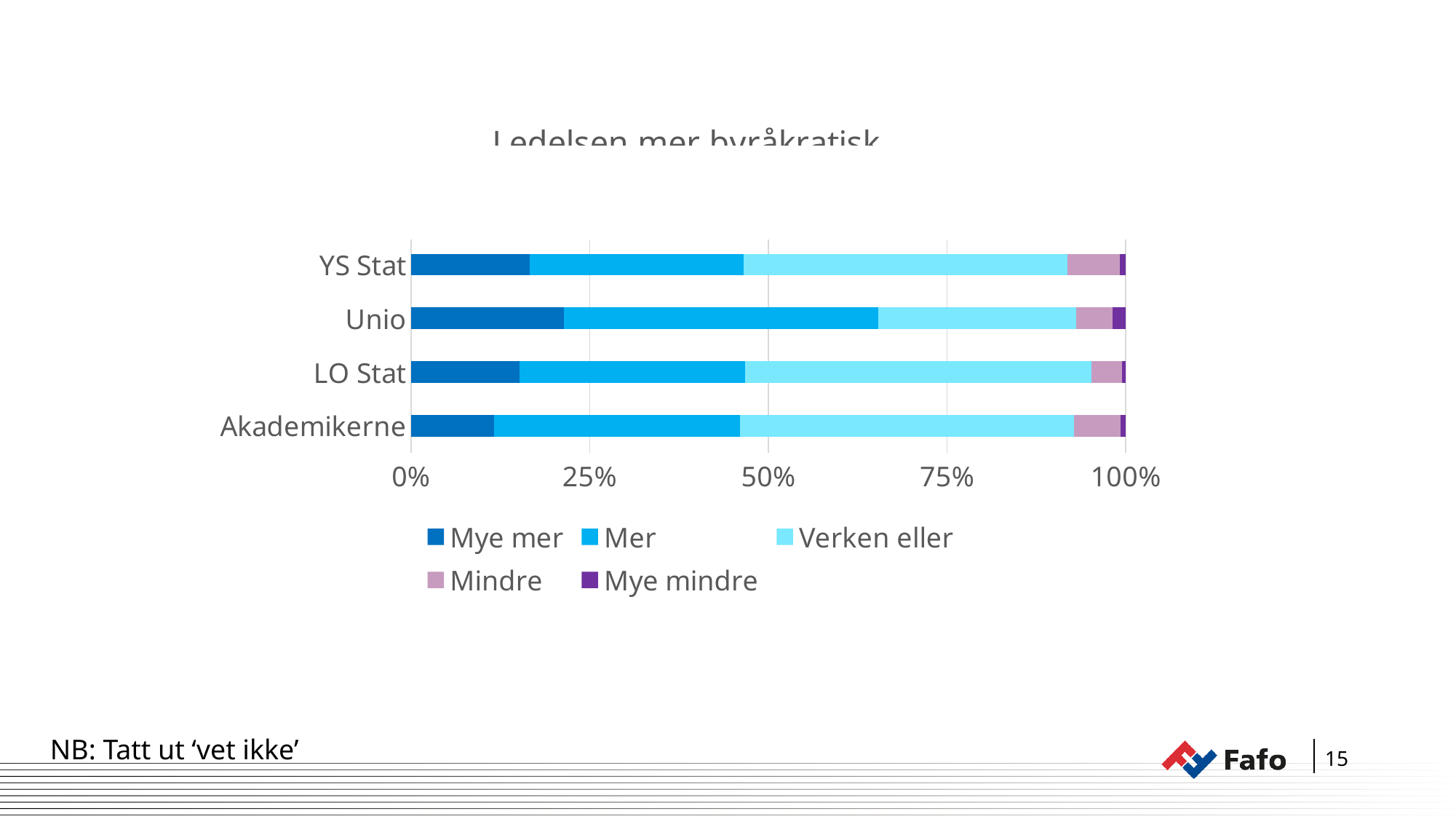
Which category has the largest 'Mer' segment? Unio How many series does the chart's legend list? 5 Which is larger: the 'Mye mer' segment for Unio or for LO Stat? Unio What does each stacked bar in the chart add up to? 100% Which category has the largest 'Mye mer' segment? Unio How many categories (organisations) are shown on the y axis of the chart? 4 Which category has the smallest 'Verken eller' segment? Unio Is the combined share of 'Mye mer' and 'Mer' for Unio greater or less than 50%? greater What kind of chart is shown on the slide? Stacked bar chart Which legend entry is shown in the darkest purple colour? Mye mindre Which category has the smallest 'Mye mer' segment? Akademikerne Is the 'Mye mer' value for Unio greater or less than 25%? less